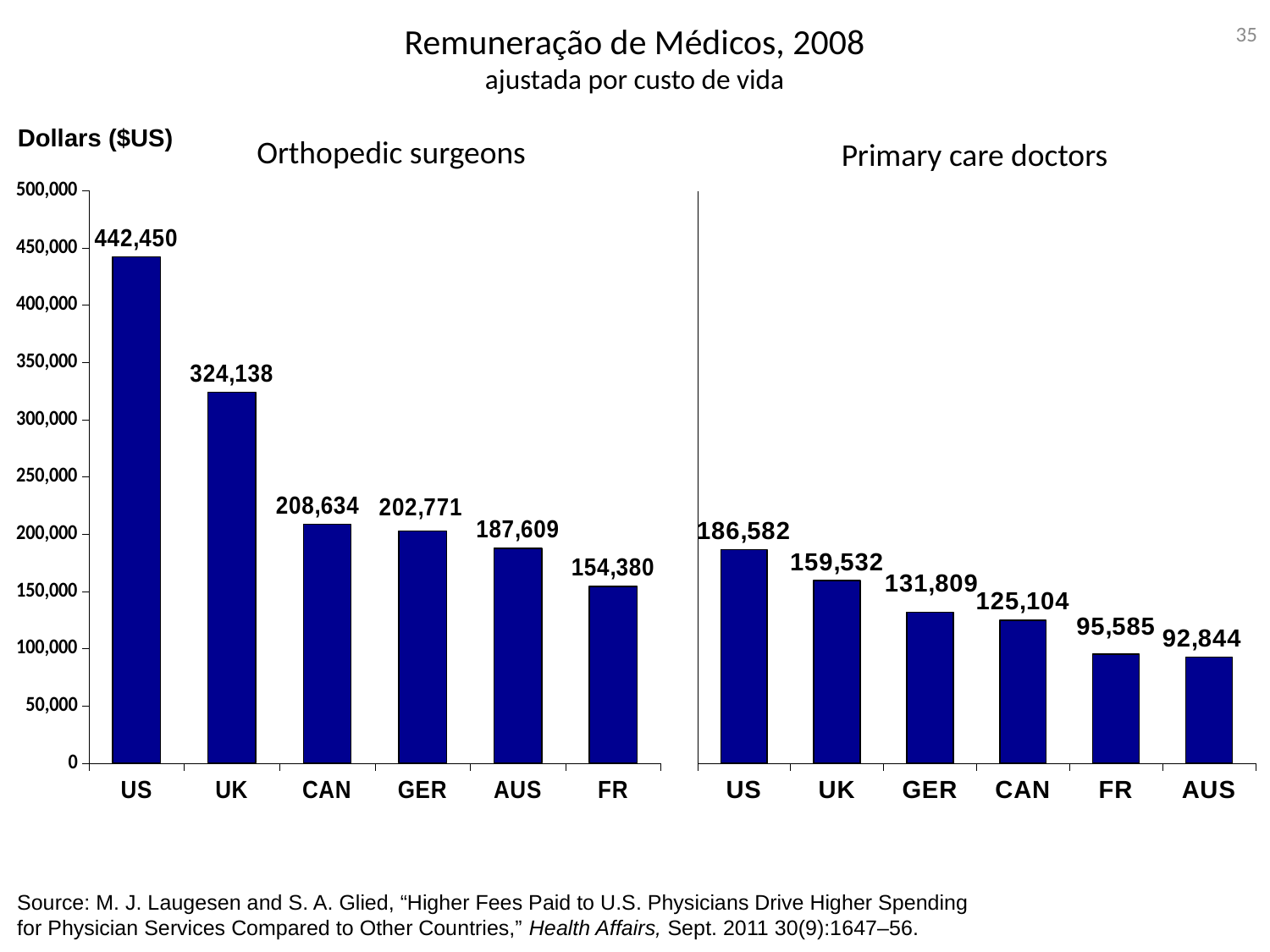
How many countries are shown in the Primary care doctors chart? 6 In the Orthopedic surgeons chart, which is larger, the value for CAN or the value for GER? CAN In the Orthopedic surgeons chart, which country has the highest value? US In the Primary care doctors chart, what is the value for GER? 131,809 In the Primary care doctors chart, which country has the lowest value? AUS In the Primary care doctors chart, is the value for CAN greater or less than 150,000? less In the Orthopedic surgeons chart, what is the value for the US? 442,450 In the Primary care doctors chart, what is the difference between the US and UK values? 27,050 What type of chart is the Orthopedic surgeons chart? Bar chart In the Orthopedic surgeons chart, what is the difference between the US and UK values? 118,312 In the Orthopedic surgeons chart, what is the value for FR? 154,380 In the Primary care doctors chart, do the values rise or fall from left to right? Fall